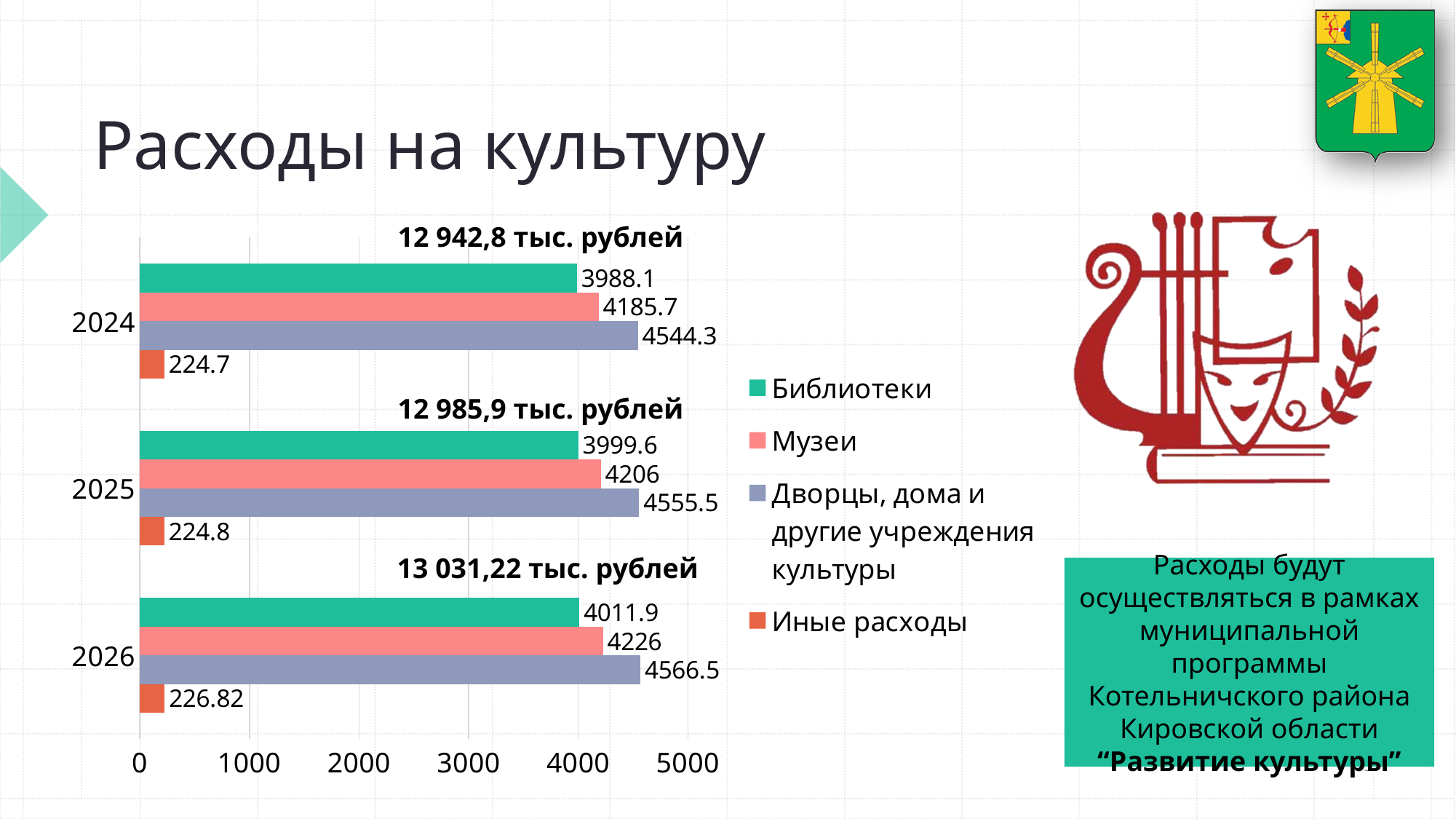
Do the values for Библиотеки rise or fall from 2024 to 2026? Rise Which series has the lowest value in 2024? Иные расходы What is the value for Библиотеки in 2024? 3988.1 Which series has the highest value in 2025? Дворцы, дома и другие учреждения культуры How many series does the legend list? 4 Which is larger in 2026: the value for Библиотеки or the value for Музеи? Музеи What is the value for Дворцы, дома и другие учреждения культуры in 2026? 4566.5 What is the value for Иные расходы in 2025? 224.8 How many year categories are shown on the chart? 3 What kind of chart is shown on the slide? Bar chart What is the difference between the Музеи value and the Библиотеки value in 2025? 206.4 What is the value for Музеи in 2026? 4226